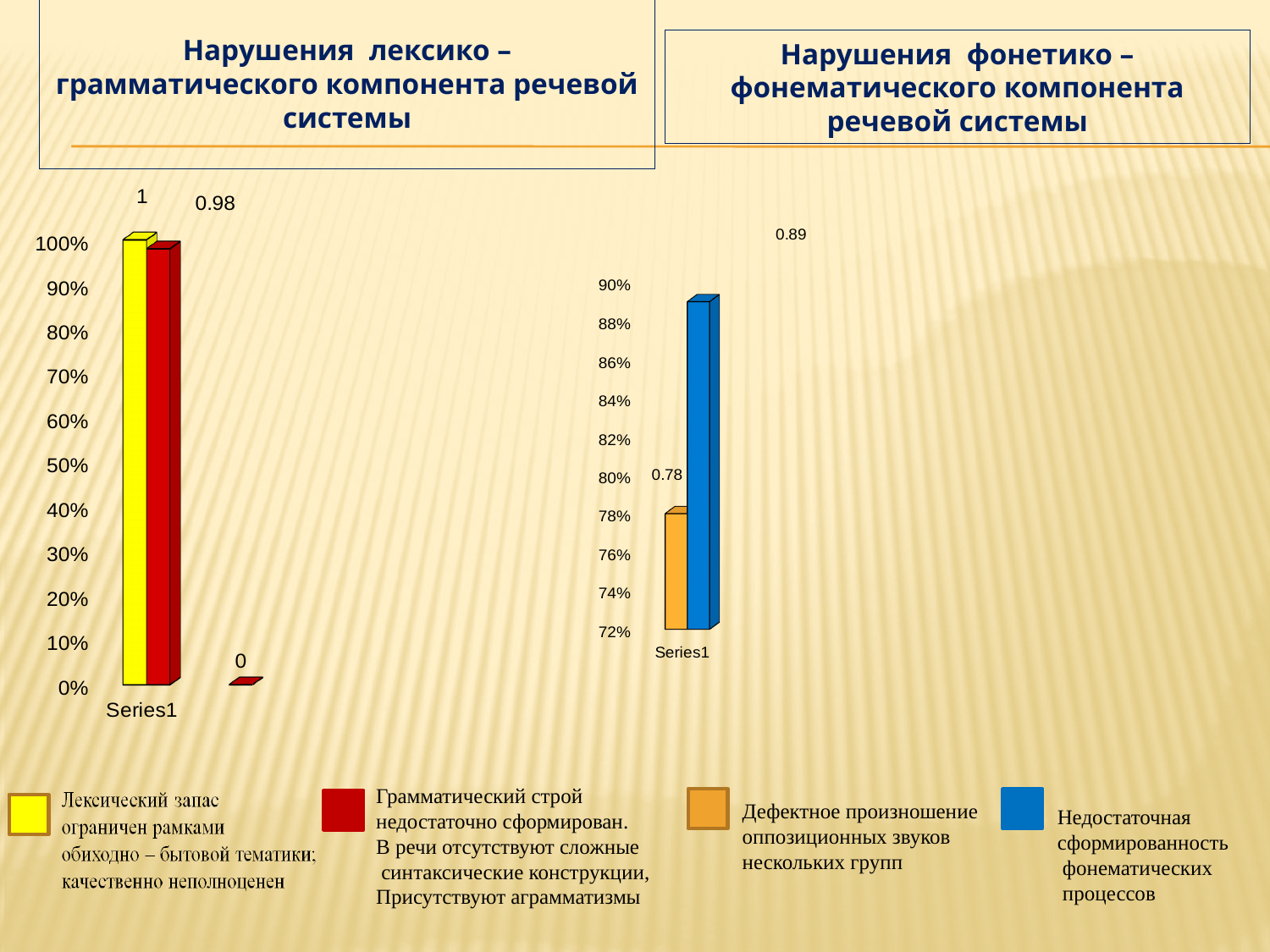
On the right chart, which bar is taller, the orange one or the blue one? the blue one On the left chart (Нарушения лексико-грамматического компонента речевой системы), what value is labelled on the yellow bar? 1 On the left chart, what is the lowest labelled value? 0 On the right chart (Нарушения фонетико-фонематического компонента речевой системы), what value is labelled on the blue bar? 0.89 What kind of chart is the left chart? bar chart On the right chart, is the value of the blue bar greater or less than 86%? greater On the right chart, what is the difference between the blue bar's value (0.89) and the orange bar's value (0.78)? 0.11 On the left chart, what is the difference between the yellow bar's value (1) and the red bar's value (0.98)? 0.02 On the right chart (Нарушения фонетико-фонематического компонента речевой системы), what value is labelled on the orange bar? 0.78 What is the category label shown on the x axis of the right chart? Series1 On the left chart (Нарушения лексико-грамматического компонента речевой системы), what value is labelled on the red bar? 0.98 On the right chart, is the value of the orange bar greater or less than 80%? less